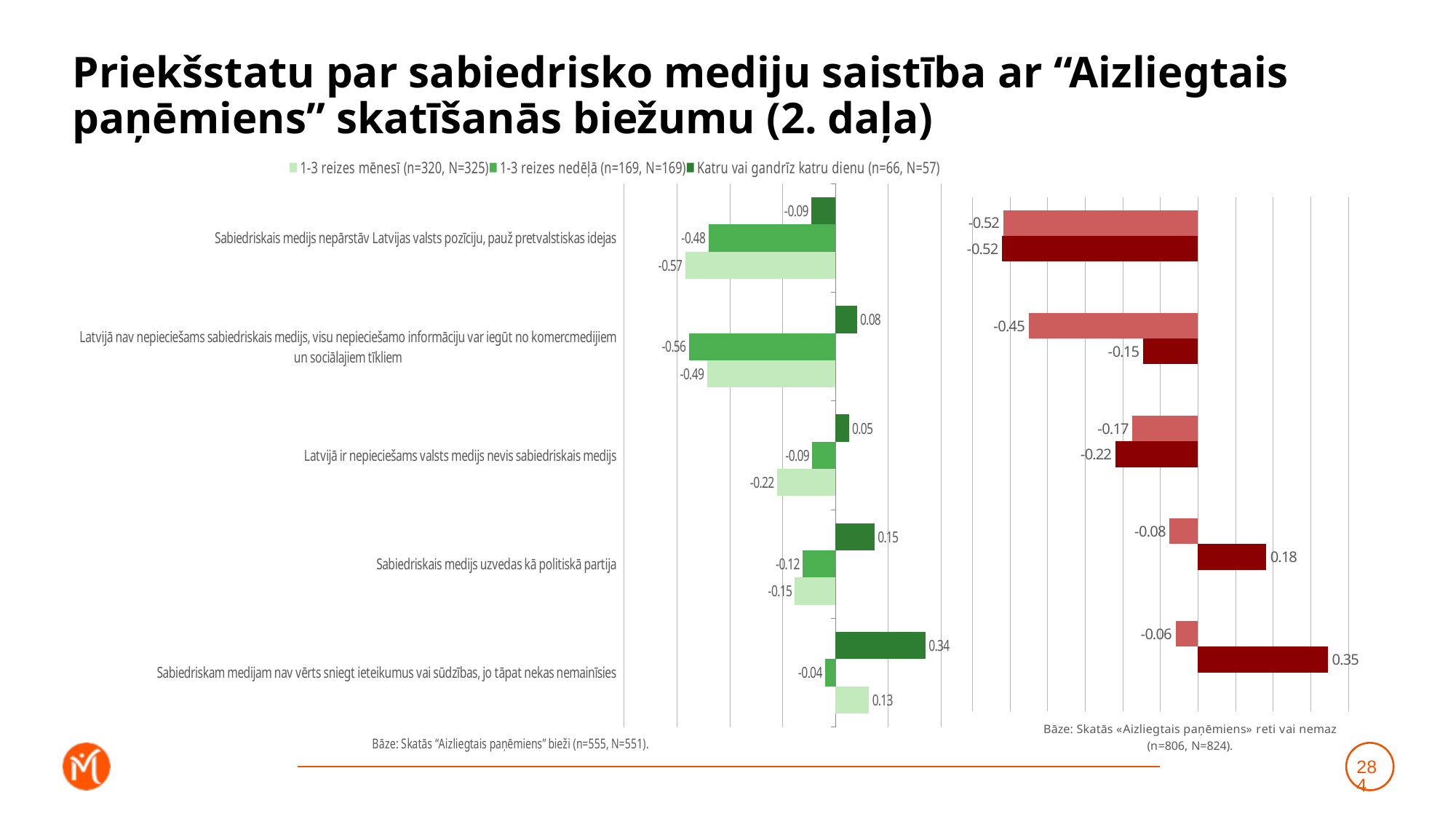
On the left (green) chart, for which statement is the "1-3 reizes mēnesī" value lowest? Sabiedriskais medijs nepārstāv Latvijas valsts pozīciju, pauž pretvalstiskas idejas On the left (green) chart, how many statements (categories) are plotted? 5 On the left (green) chart, what is the value for "Katru vai gandrīz katru dienu" for the statement "Sabiedriskam medijam nav vērts sniegt ieteikumus vai sūdzības, jo tāpat nekas nemainīsies"? 0.34 On the left (green) chart, what is the difference between the "Katru vai gandrīz katru dienu" value (0.15) and the "1-3 reizes mēnesī" value (-0.15) for "Sabiedriskais medijs uzvedas kā politiskā partija"? 0.30 What kind of chart is the left (green) chart? Bar chart On the right (red) chart, what is the value of the dark red bar for the statement "Sabiedriskam medijam nav vērts sniegt ieteikumus vai sūdzības, jo tāpat nekas nemainīsies"? 0.35 On the left (green) chart, for which statement is the "Katru vai gandrīz katru dienu" value highest? Sabiedriskam medijam nav vērts sniegt ieteikumus vai sūdzības, jo tāpat nekas nemainīsies What is the base (Bāze) stated under the left (green) chart? Skatās "Aizliegtais paņēmiens" bieži (n=555, N=551) On the right (red) chart, which is larger for "Latvijā nav nepieciešams sabiedriskais medijs...": the lighter red bar (-0.45) or the dark red bar (-0.15)? The dark red bar (-0.15) On the left (green) chart, what is the value for "1-3 reizes nedēļā" for the statement "Latvijā nav nepieciešams sabiedriskais medijs, visu nepieciešamo informāciju var iegūt no komercmedijiem un sociālajiem tīkliem"? -0.56 On the left (green) chart, what is the value for "1-3 reizes mēnesī" for the statement "Sabiedriskais medijs nepārstāv Latvijas valsts pozīciju, pauž pretvalstiskas idejas"? -0.57 On the left (green) chart, how many series does the legend list? 3